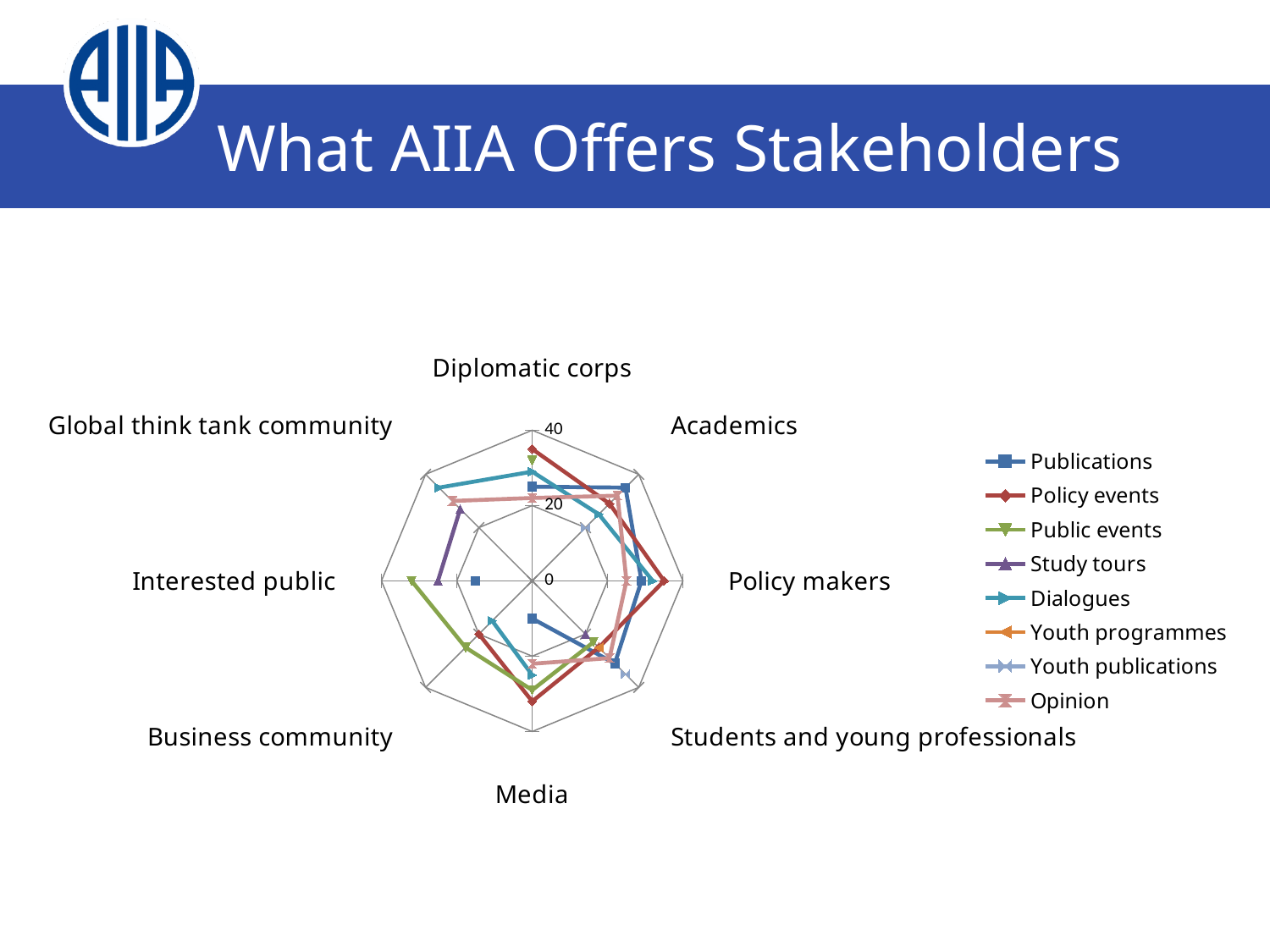
Is the value of Publications for Media greater or less than 20? less Is the value of Dialogues for Business community greater or less than 20? less What kind of chart is shown on the slide? Radar chart Is the value of Dialogues for Global think tank community greater or less than 20? greater Which is larger: the Publications value for Policy makers or the Publications value for Interested public? Policy makers For the Dialogues series, which stakeholder category has the highest value? Global think tank community What is the title of the slide containing the chart? What AIIA Offers Stakeholders How many series does the legend list? 8 How many stakeholder categories are plotted around the radar chart? 8